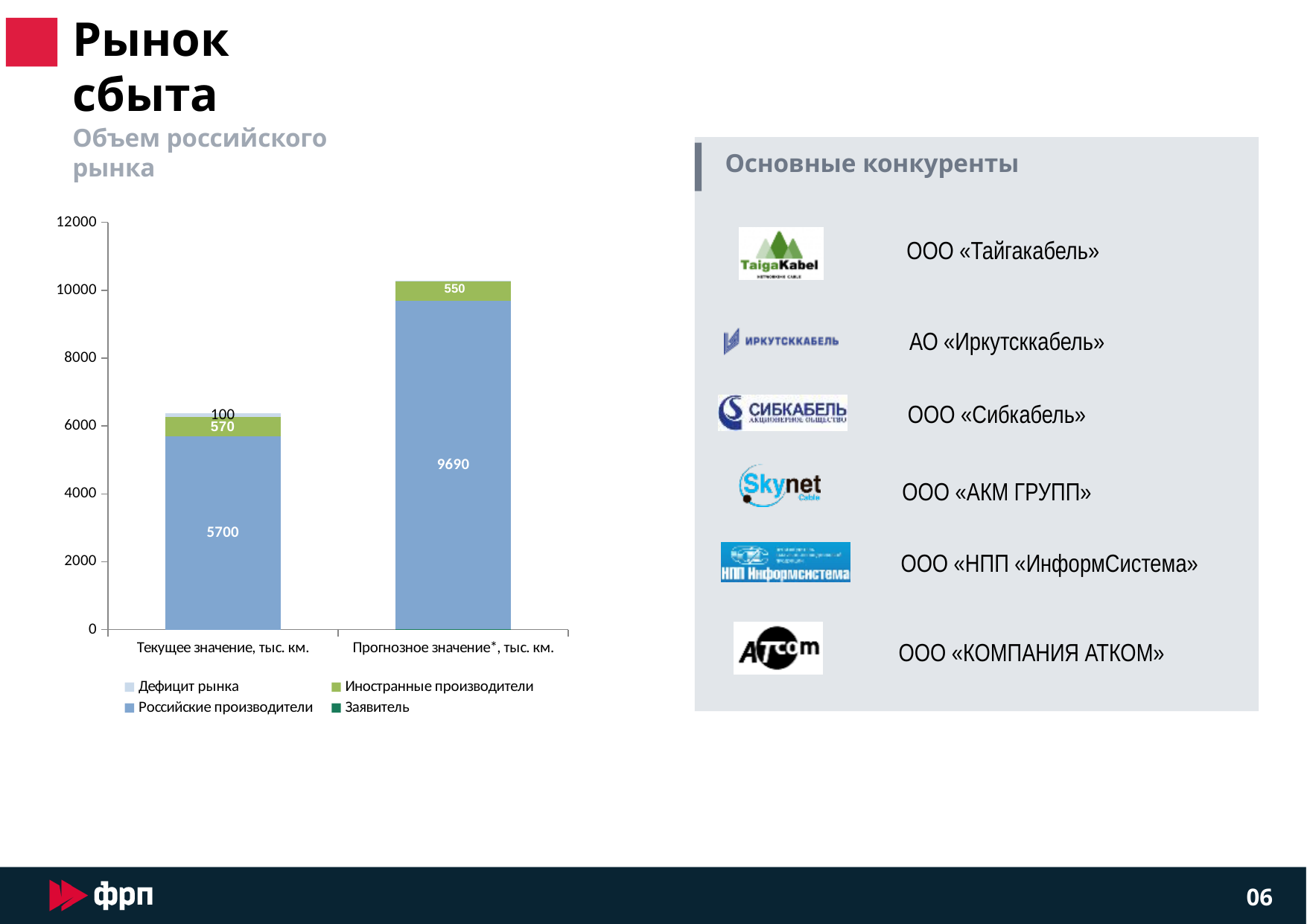
By how much does the Российские производители value for Прогнозное значение* exceed the value for Текущее значение? 3990 Which category has the larger Иностранные производители value: Текущее значение or Прогнозное значение*? Текущее значение, тыс. км. How many categories are shown on the x axis? 2 What kind of chart is shown on the slide? stacked bar chart How many series does the legend list? 4 What is the value of Иностранные производители for Прогнозное значение*, тыс. км.? 550 What is the value of Российские производители for Текущее значение, тыс. км.? 5700 What is the value of Дефицит рынка for Текущее значение, тыс. км.? 100 What is the value of Иностранные производители for Текущее значение, тыс. км.? 570 What is the value of Российские производители for Прогнозное значение*, тыс. км.? 9690 Is the total height of the Прогнозное значение* bar greater or less than 10000? greater What is the difference between the Иностранные производители values for Текущее значение and Прогнозное значение*? 20